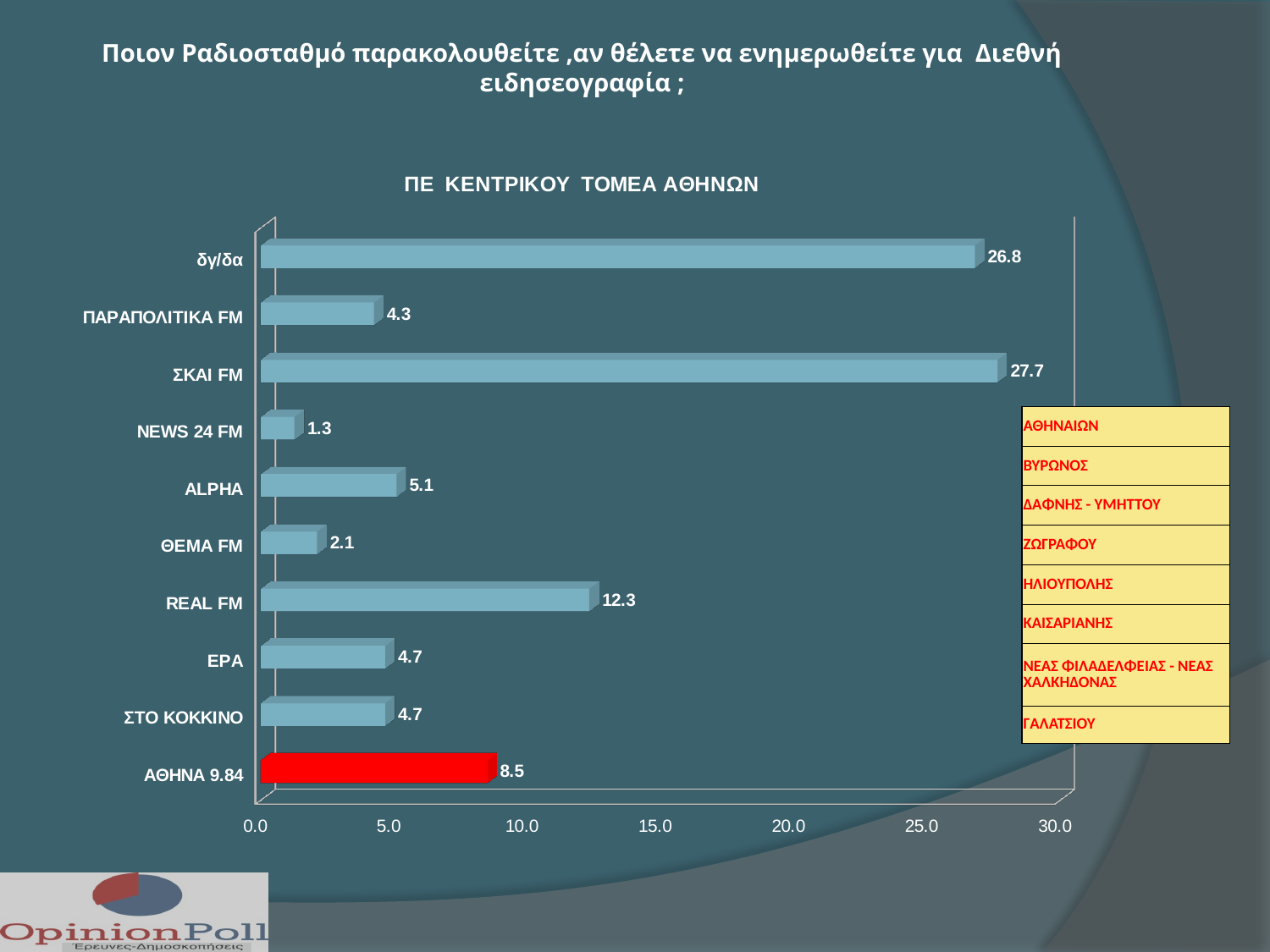
What is the value for ΣΚΑΙ FM? 27.7 How many categories are shown in the chart? 10 What is the value for NEWS 24 FM? 1.3 What kind of chart is shown on the slide? bar chart What is the value for REAL FM? 12.3 Which category has the highest value? ΣΚΑΙ FM Which category has the lowest value? NEWS 24 FM What is the title of the chart? ΠΕ ΚΕΝΤΡΙΚΟΥ ΤΟΜΕΑ ΑΘΗΝΩΝ What is the difference between the values for ΣΚΑΙ FM and δγ/δα? 0.9 Which is larger, the value for ALPHA or the value for ΠΑΡΑΠΟΛΙΤΙΚΑ FM? ALPHA Is the value for REAL FM greater or less than 10.0? greater What is the value for ΑΘΗΝΑ 9.84? 8.5